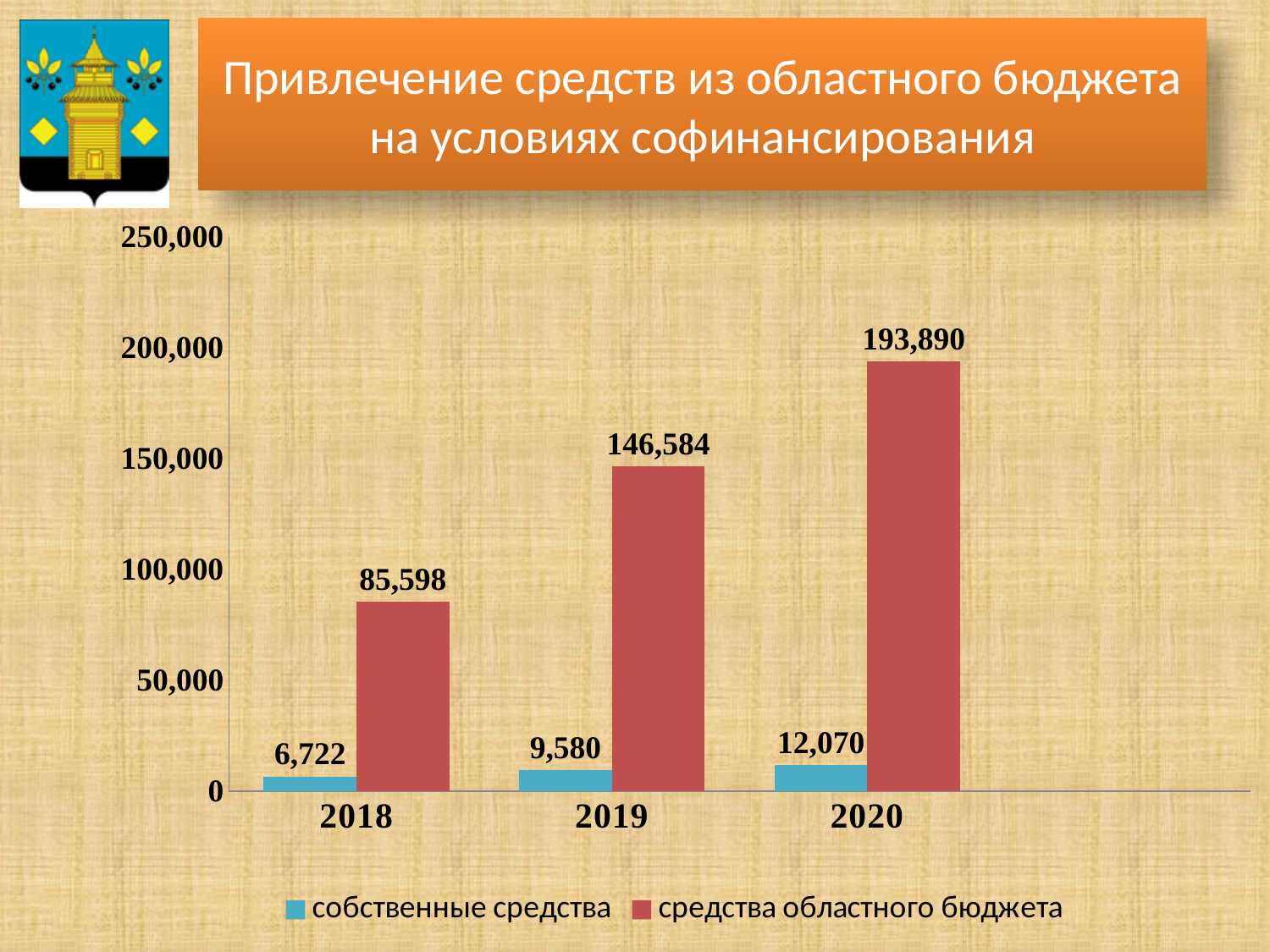
In which year is the value for собственные средства the lowest? 2018 What is the value for собственные средства in 2020? 12,070 Which is larger: средства областного бюджета in 2018 or собственные средства in 2020? средства областного бюджета in 2018 What is the difference between собственные средства in 2020 and in 2018? 5,348 In which year is the value for средства областного бюджета the highest? 2020 Is the value for средства областного бюджета in 2019 greater or less than 150,000? less What is the difference between средства областного бюджета in 2020 and in 2019? 47,306 What is the value for средства областного бюджета in 2019? 146,584 Do the values for средства областного бюджета rise or fall from 2018 to 2020? rise What is the value for собственные средства in 2018? 6,722 How many series does the legend list? 2 How many years are shown on the x axis? 3